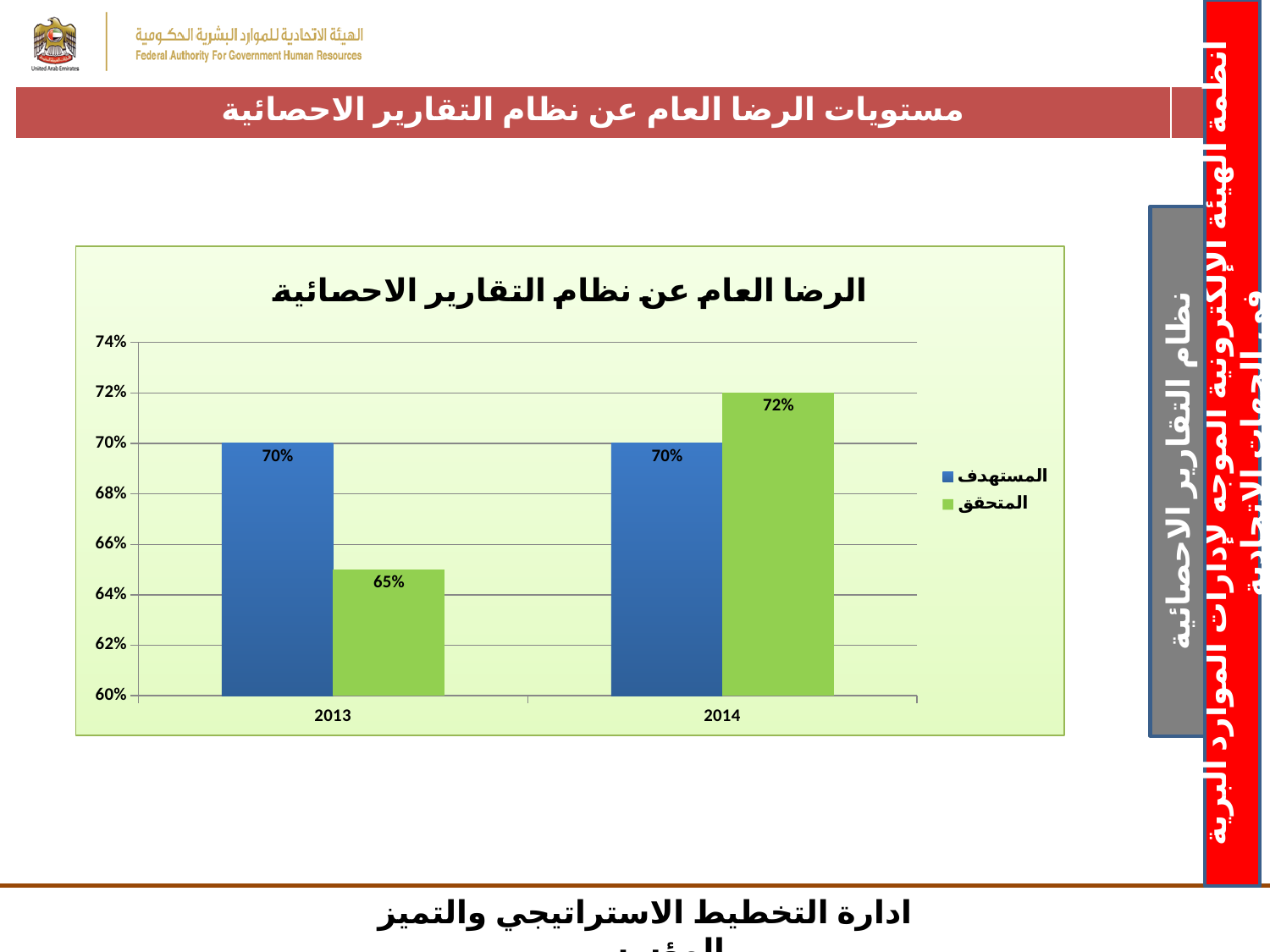
What kind of chart is shown? bar chart In 2014, which is larger, المستهدف or المتحقق? المتحقق In which year is المتحقق lowest? 2013 What is the difference between المتحقق in 2014 and المتحقق in 2013? 7% What is the value of المتحقق for 2014? 72% In which year is المتحقق highest? 2014 What is the value of المستهدف for 2014? 70% How many series does the legend list? 2 What is the value of المتحقق for 2013? 65% What is the difference between المستهدف and المتحقق in 2013? 5% How many years are shown on the x axis? 2 What is the title of the chart? الرضا العام عن نظام التقارير الاحصائية